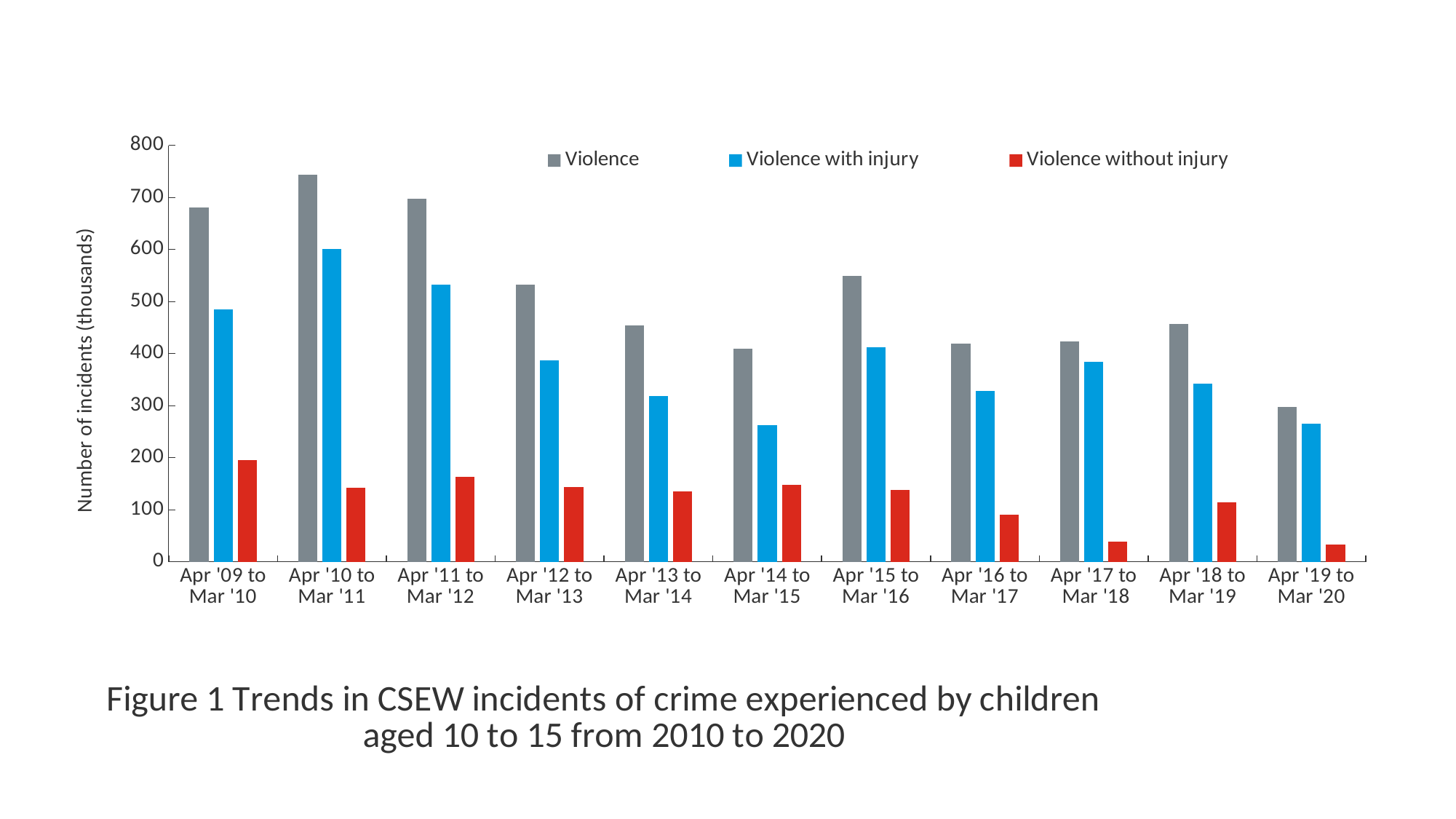
Is the Violence value for Apr '10 to Mar '11 greater or less than 700? greater Is the Violence with injury value for Apr '14 to Mar '15 greater or less than 300? less Which period has the larger Violence value, Apr '15 to Mar '16 or Apr '16 to Mar '17? Apr '15 to Mar '16 Is the Violence without injury value for Apr '17 to Mar '18 greater or less than 100? less In which period is the Violence value lowest? Apr '19 to Mar '20 What is the label on the y axis? Number of incidents (thousands) In which period is the Violence value highest? Apr '10 to Mar '11 How many series does the legend list? 3 In which period is the Violence without injury value highest? Apr '09 to Mar '10 In which period is the Violence with injury value highest? Apr '10 to Mar '11 What kind of chart is shown on the slide? Bar chart How many time periods are shown on the x axis? 11